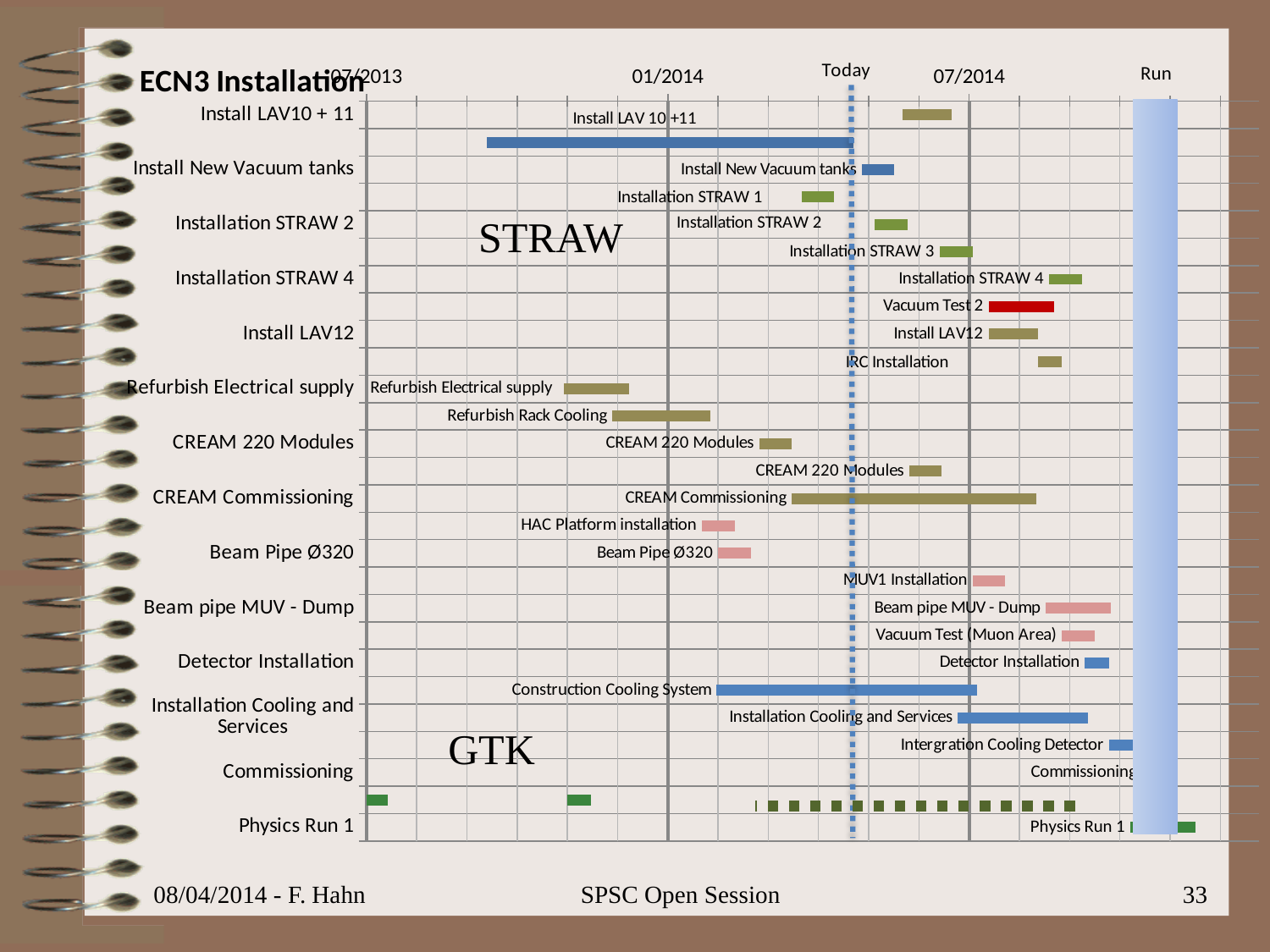
Which is scheduled later, Install LAV 10+11 or Install LAV12? Install LAV12 Does the Install LAV12 bar start before or after the 'Today' line? after What is the title of the chart? ECN3 Installation What kind of chart is shown on the slide? Gantt chart Which starts earlier, Installation STRAW 1 or Installation STRAW 4? Installation STRAW 1 Does the Installation STRAW 1 bar end before or after the 'Today' line? before Which task is drawn with a red bar? Vacuum Test 2 Which task starts after Installation STRAW 3, STRAW 2 or STRAW 4? Installation STRAW 4 What does the dotted vertical line on the chart mark? Today Which date labels are printed along the time axis? 07/2013, 01/2014, 07/2014